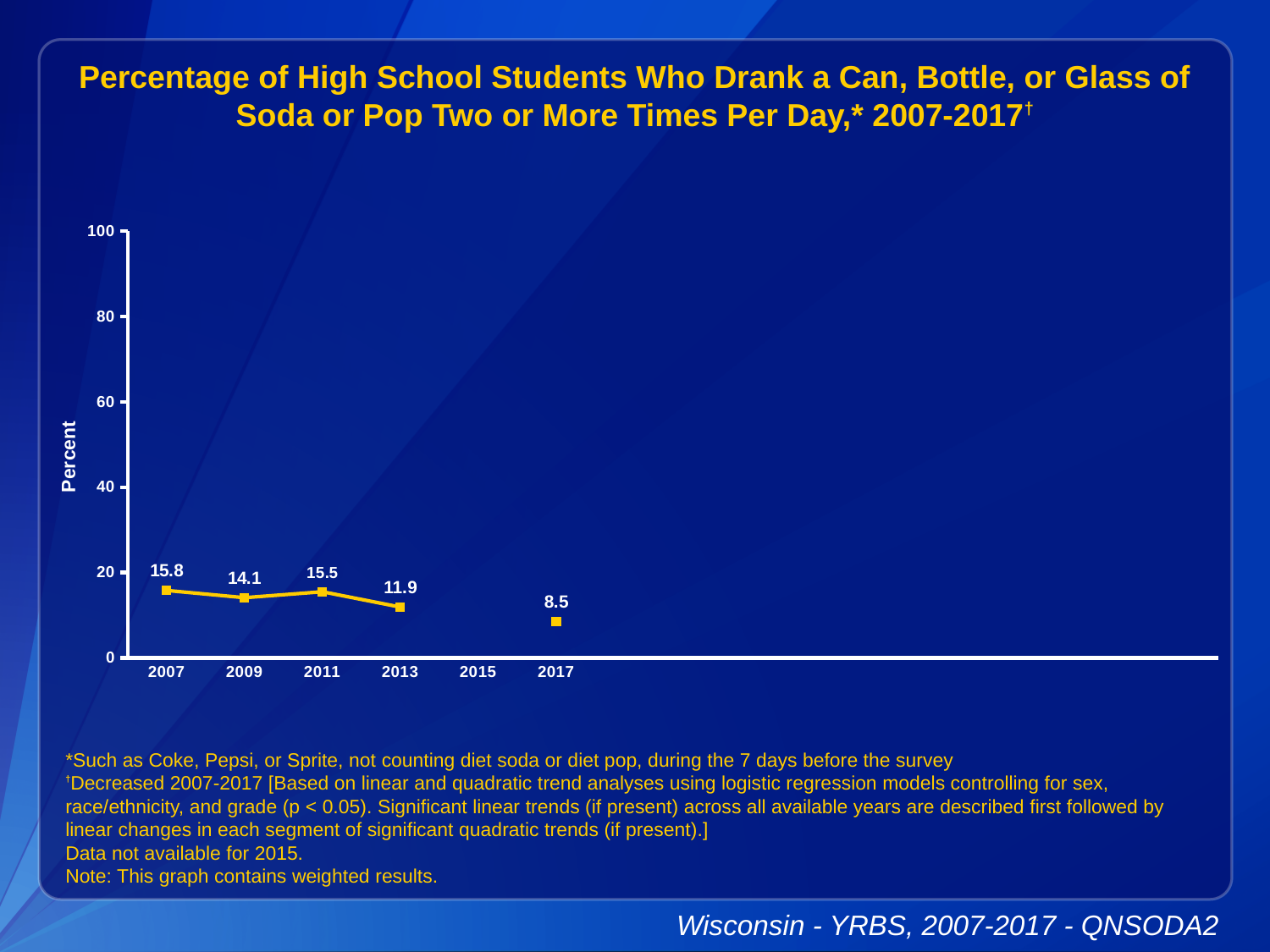
Which year has the lowest percentage? 2017 Which year has the highest percentage? 2007 What is the difference between the 2011 value and the 2009 value? 1.4 What is the value plotted for 2013? 11.9 Overall, do the values rise or fall from 2007 to 2017? fall What is the value plotted for 2017? 8.5 How many years have data points plotted on the chart? 5 Is the value for 2013 greater or less than 20? less What kind of chart is shown on the slide? line chart Which is larger, the value for 2009 or the value for 2011? 2011 What percentage of high school students drank soda or pop two or more times per day in 2007? 15.8 What is the difference between the 2007 value and the 2017 value? 7.3